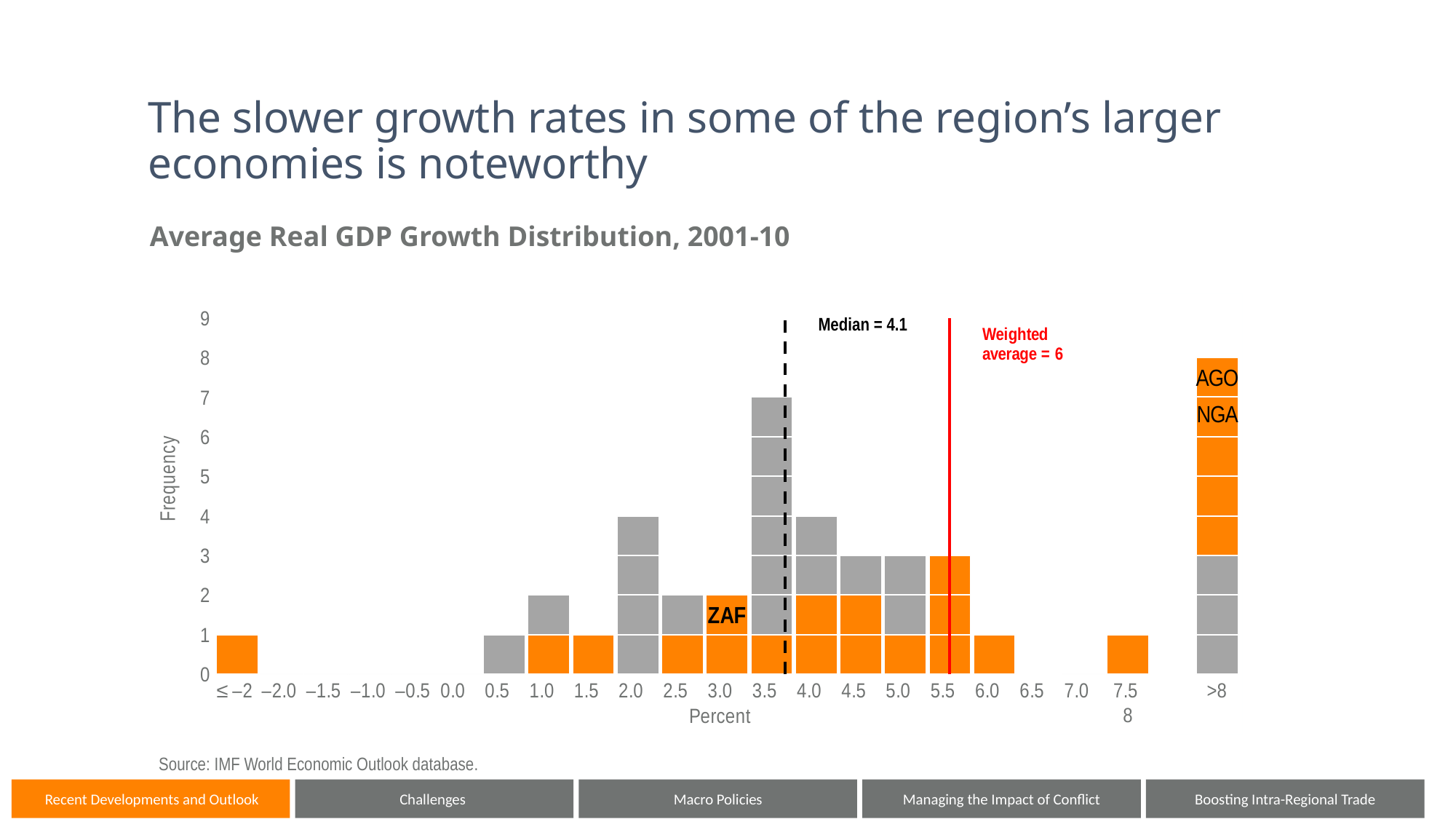
What kind of chart is shown on the slide? Bar chart (histogram) What is the frequency for the 2.0 percent bin? 4 What is the median value marked on the chart? 4.1 What is the weighted average marked on the chart? 6 What is the difference in frequency between the >8 bin and the 3.5 bin? 1 Which two countries are labelled in the >8 bin? AGO and NGA Which bin has a higher frequency, 3.5 or 4.0? 3.5 In which percent bin is ZAF labelled? 3.0 What is the frequency for the 3.5 percent bin? 7 Is the frequency for the 3.5 bin greater or less than 5? greater Which percent bin has the highest frequency? >8 What is the frequency for the >8 percent bin? 8